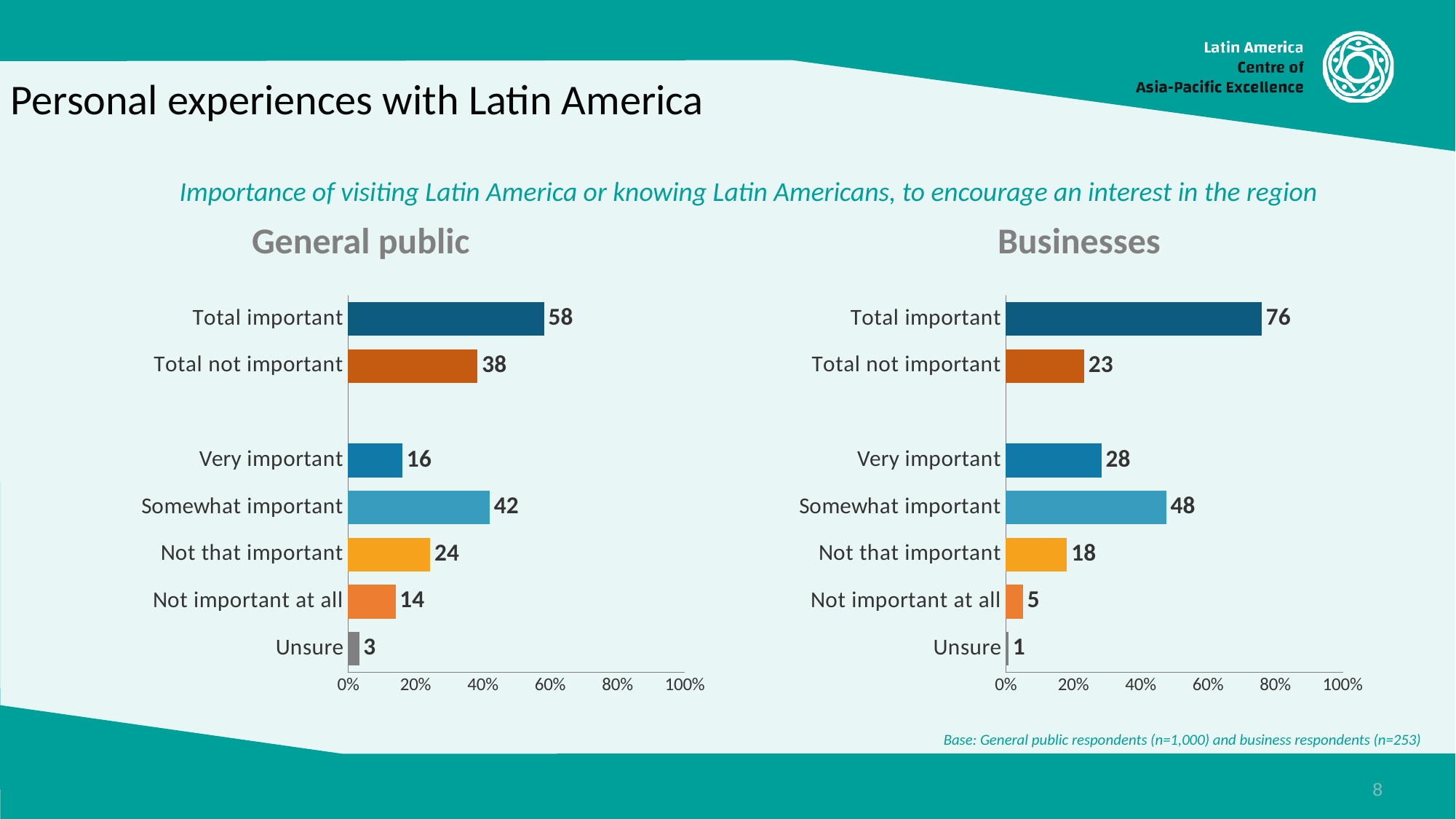
In the Businesses chart, what is the value for Total important? 76 What is the subtitle shown above the two charts? Importance of visiting Latin America or knowing Latin Americans, to encourage an interest in the region In the General public chart, what is the difference between Total important and Total not important? 20 How many categories are shown in the Businesses chart? 7 In the Businesses chart, what is the difference between Somewhat important and Very important? 20 In the General public chart, is the value for Total important greater or less than 40%? greater In the General public chart, which category has the lowest value? Unsure What kind of chart is the General public chart? Bar chart In the General public chart, what is the value for Somewhat important? 42 Which is larger: Very important in the General public chart or Very important in the Businesses chart? Businesses In the Businesses chart, which category has the highest value? Total important In the Businesses chart, what is the value for Not important at all? 5